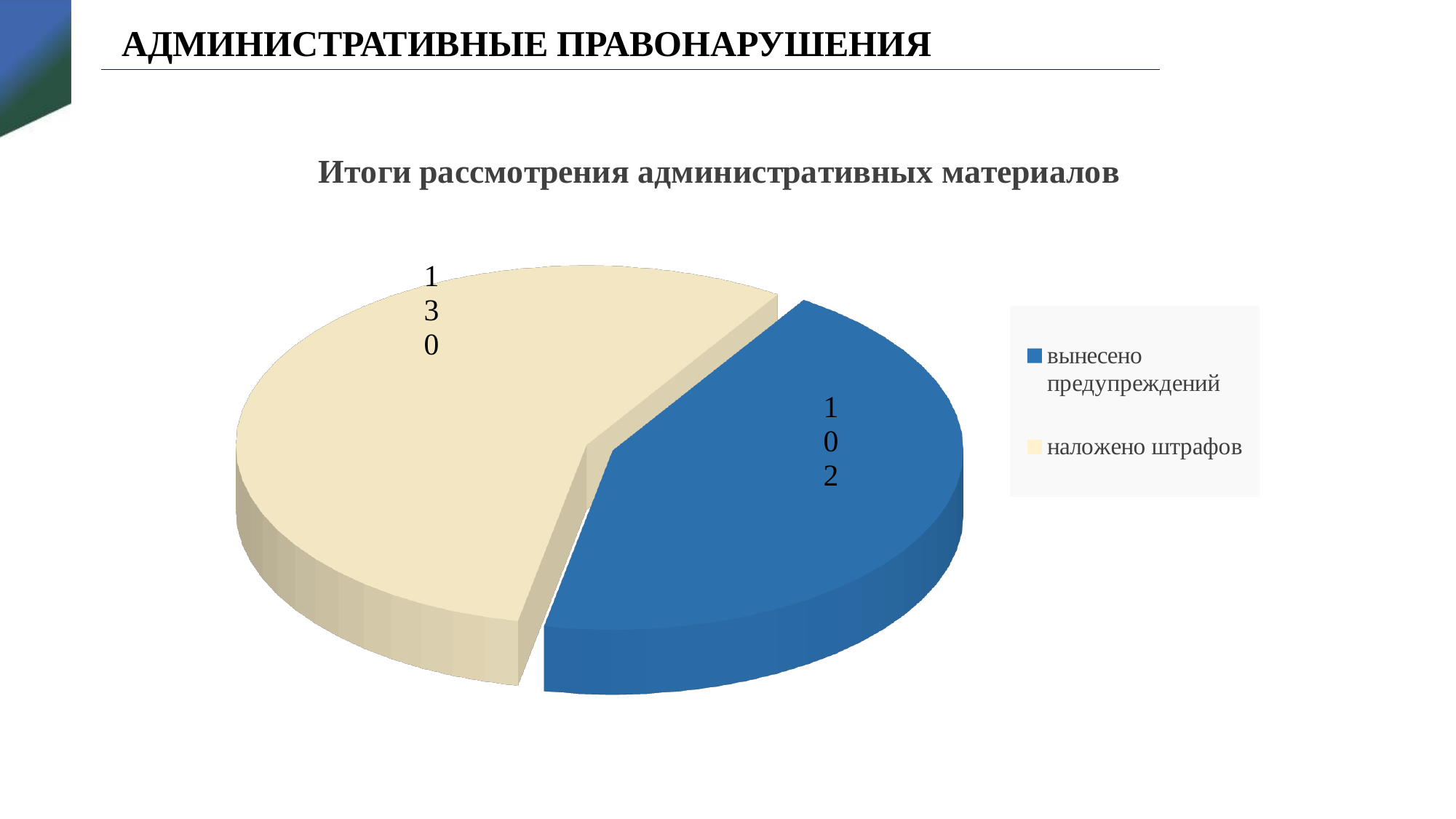
Which category has the smallest slice of the pie? вынесено предупреждений What kind of chart is shown on the slide? pie chart How many entries does the legend list? 2 What is the value for "вынесено предупреждений"? 102 Which is larger: the value for "вынесено предупреждений" or the value for "наложено штрафов"? наложено штрафов What is the title of the chart? Итоги рассмотрения административных материалов Which colour represents "вынесено предупреждений" in the pie chart? blue Which category has the largest slice of the pie? наложено штрафов What is the total of the two slices in the pie chart? 232 What is the difference between the values for "наложено штрафов" and "вынесено предупреждений"? 28 What is the value for "наложено штрафов"? 130 How many slices does the pie chart have? 2